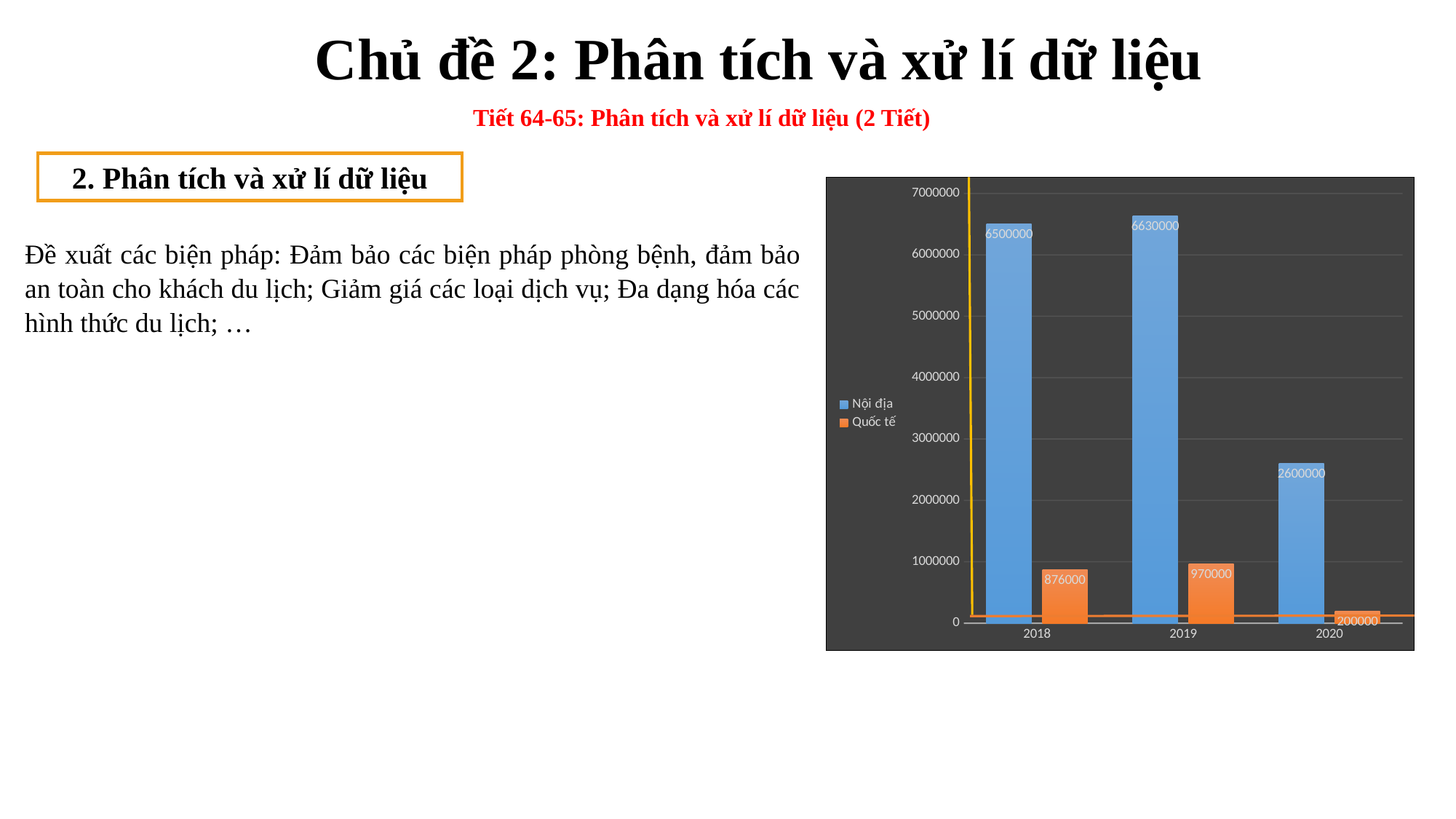
What is the difference between the Nội địa values for 2019 and 2018? 130000 Which year has the highest Nội địa value? 2019 What type of chart is shown on the slide? bar chart What is the value for Nội địa in 2020? 2600000 Which is larger, the Quốc tế value in 2019 or in 2018? 2019 Which year has the lowest Quốc tế value? 2020 How many years are shown on the x axis of the chart? 3 Which colour represents the Quốc tế series in the chart? orange How many series does the chart legend list? 2 What is the value for Nội địa in 2019? 6630000 What is the value for Quốc tế in 2018? 876000 Does the Nội địa value fall or rise from 2019 to 2020? fall